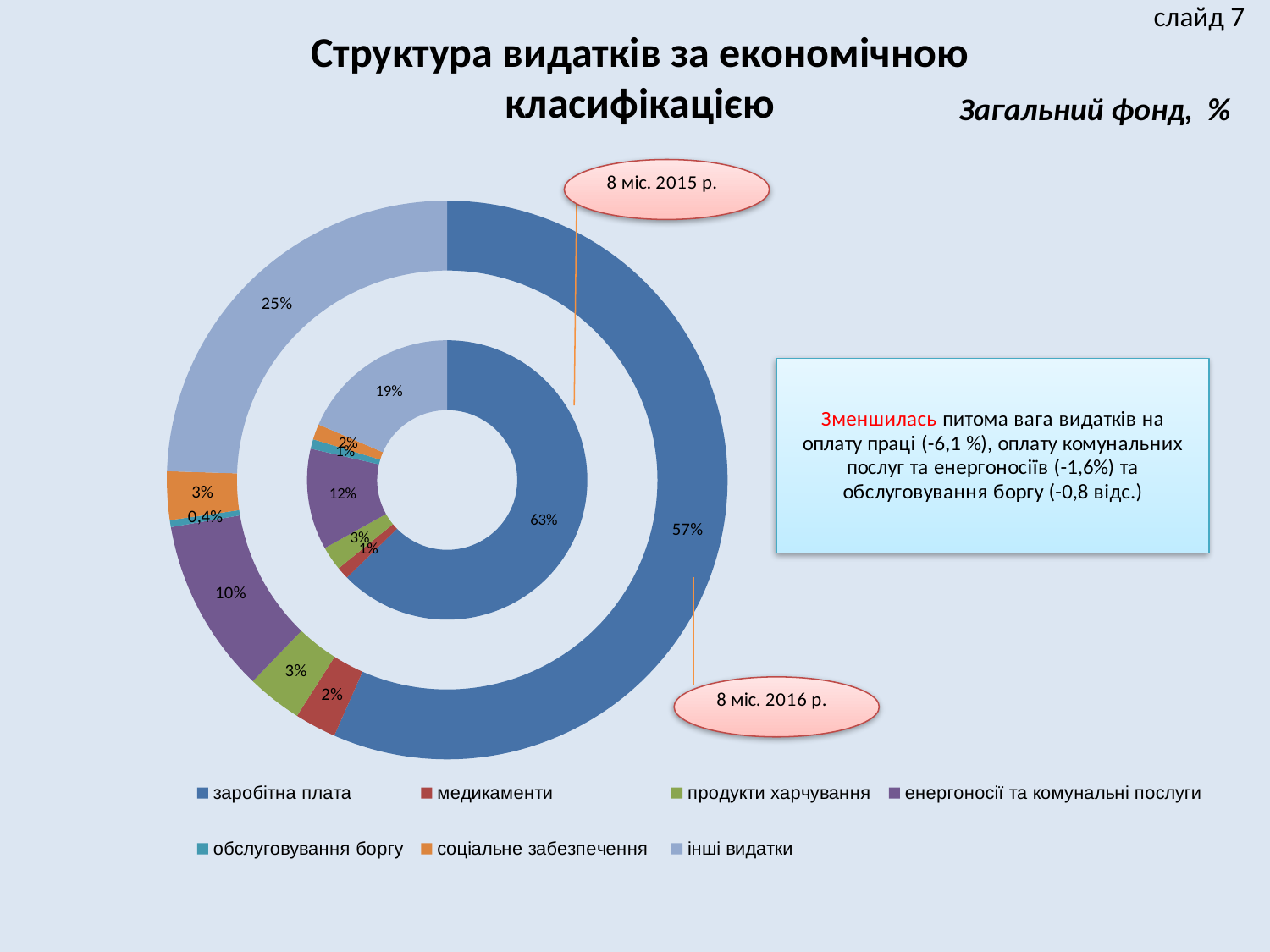
How many categories does the legend list? 7 What is the share of обслуговування боргу in the outer ring (8 міс. 2016 р.)? 0,4% What kind of chart is shown on the slide? Doughnut chart What is the share of заробітна плата in the inner ring (8 міс. 2015 р.)? 63% What is the share of заробітна плата in the outer ring (8 міс. 2016 р.)? 57% What is the share of енергоносії та комунальні послуги in the inner ring (8 міс. 2015 р.)? 12% What is the share of інші видатки in the outer ring (8 міс. 2016 р.)? 25% What is the share of соціальне забезпечення in the inner ring (8 міс. 2015 р.)? 2% Which category has the largest share in the outer ring (8 міс. 2016 р.)? заробітна плата Which category has the smallest share in the outer ring (8 міс. 2016 р.)? обслуговування боргу Which is larger: the share of інші видатки in the inner ring (2015) or in the outer ring (2016)? Outer ring (2016), 25% By how many percentage points did the share of заробітна плата change from the inner ring (2015) to the outer ring (2016)? 6 percentage points lower